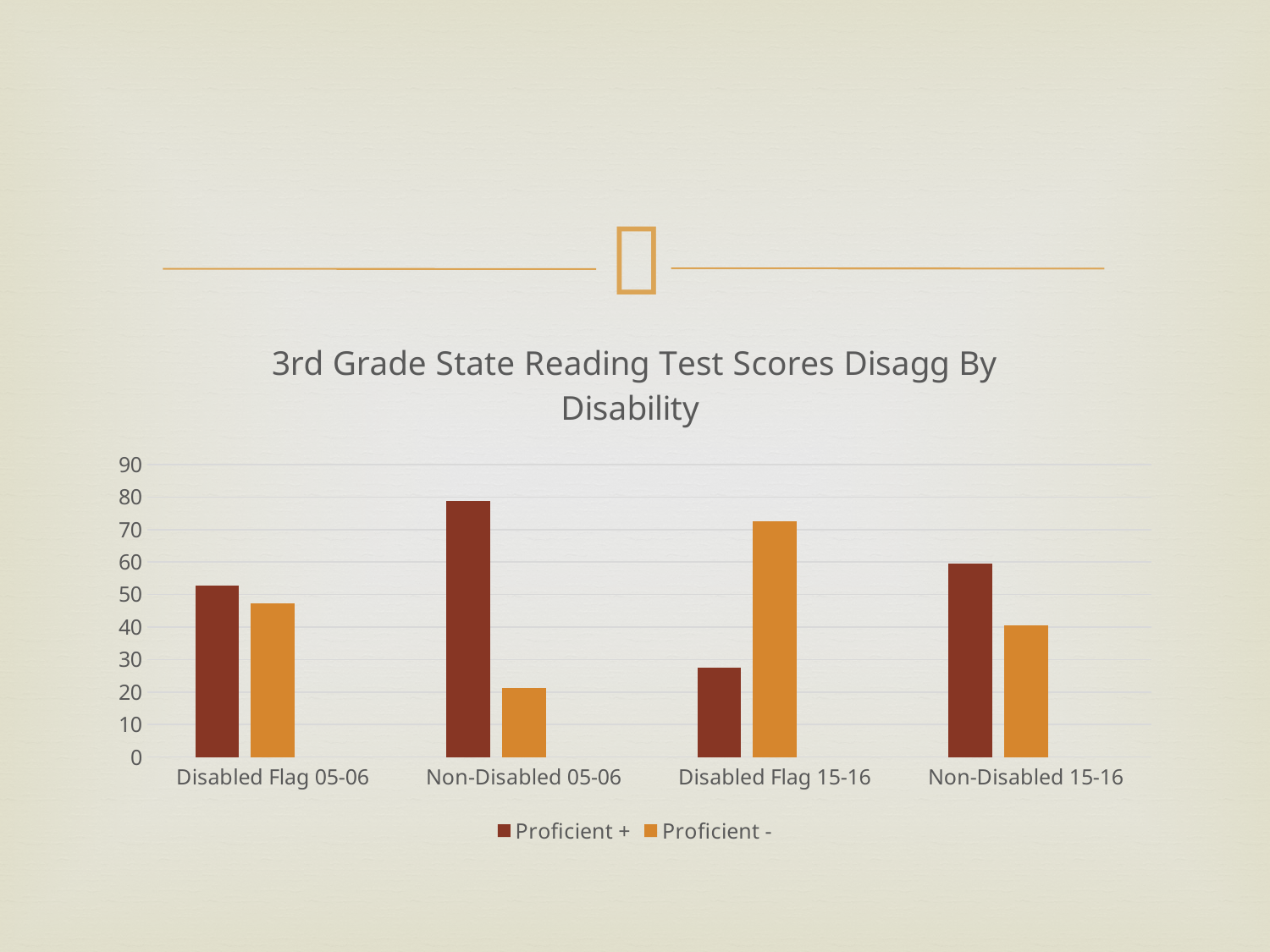
Which category has the lowest Proficient - value? Non-Disabled 05-06 Which category has the highest Proficient - value? Disabled Flag 15-16 Is the Proficient + value for Disabled Flag 15-16 greater or less than 40? less What is the title of the chart? 3rd Grade State Reading Test Scores Disagg By Disability How many series does the legend list? 2 Which category has the lowest Proficient + value? Disabled Flag 15-16 How many categories are shown on the x axis? 4 Which category has the highest Proficient + value? Non-Disabled 05-06 Is the Proficient + value for Non-Disabled 05-06 greater or less than 70? greater For Non-Disabled 15-16, which is larger: Proficient + or Proficient -? Proficient + Is the Proficient - value for Non-Disabled 05-06 greater or less than 30? less What kind of chart is shown on the slide? bar chart